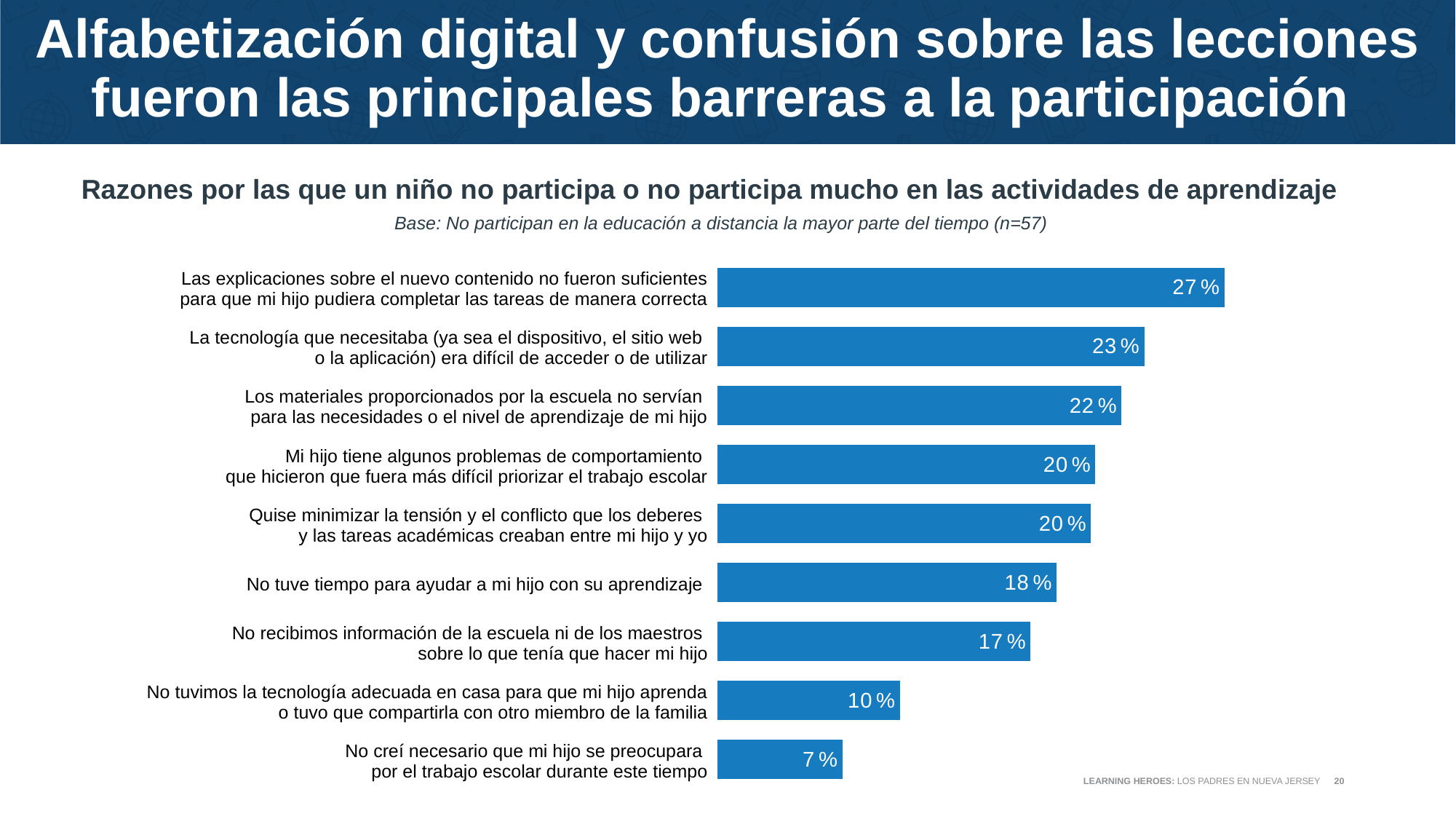
How many reasons (bars) are shown in the chart? 9 What percentage is shown for not having adequate technology at home or having to share it with another family member? 10 % What type of chart is shown on the slide? Bar chart How many reasons share the value 20 %? 2 What is the difference in percentage points between the highest bar (27 %) and the lowest bar (7 %)? 20 What is the difference in percentage points between 'La tecnología que necesitaba ... era difícil de acceder o de utilizar' and 'No recibimos información de la escuela ni de los maestros ...'? 6 What percentage of parents said the explanations about new content were not sufficient for their child to complete tasks correctly? 27 % What is the base (sample size) stated for the chart? n=57 Which reason has the highest percentage in the chart? Las explicaciones sobre el nuevo contenido no fueron suficientes para que mi hijo pudiera completar las tareas de manera correcta What value is shown for 'No tuve tiempo para ayudar a mi hijo con su aprendizaje'? 18 % Which is larger: the value for 'Los materiales proporcionados por la escuela no servían ...' or the value for 'No tuve tiempo para ayudar a mi hijo con su aprendizaje'? Los materiales proporcionados por la escuela no servían para las necesidades o el nivel de aprendizaje de mi hijo Which reason has the lowest percentage in the chart? No creí necesario que mi hijo se preocupara por el trabajo escolar durante este tiempo